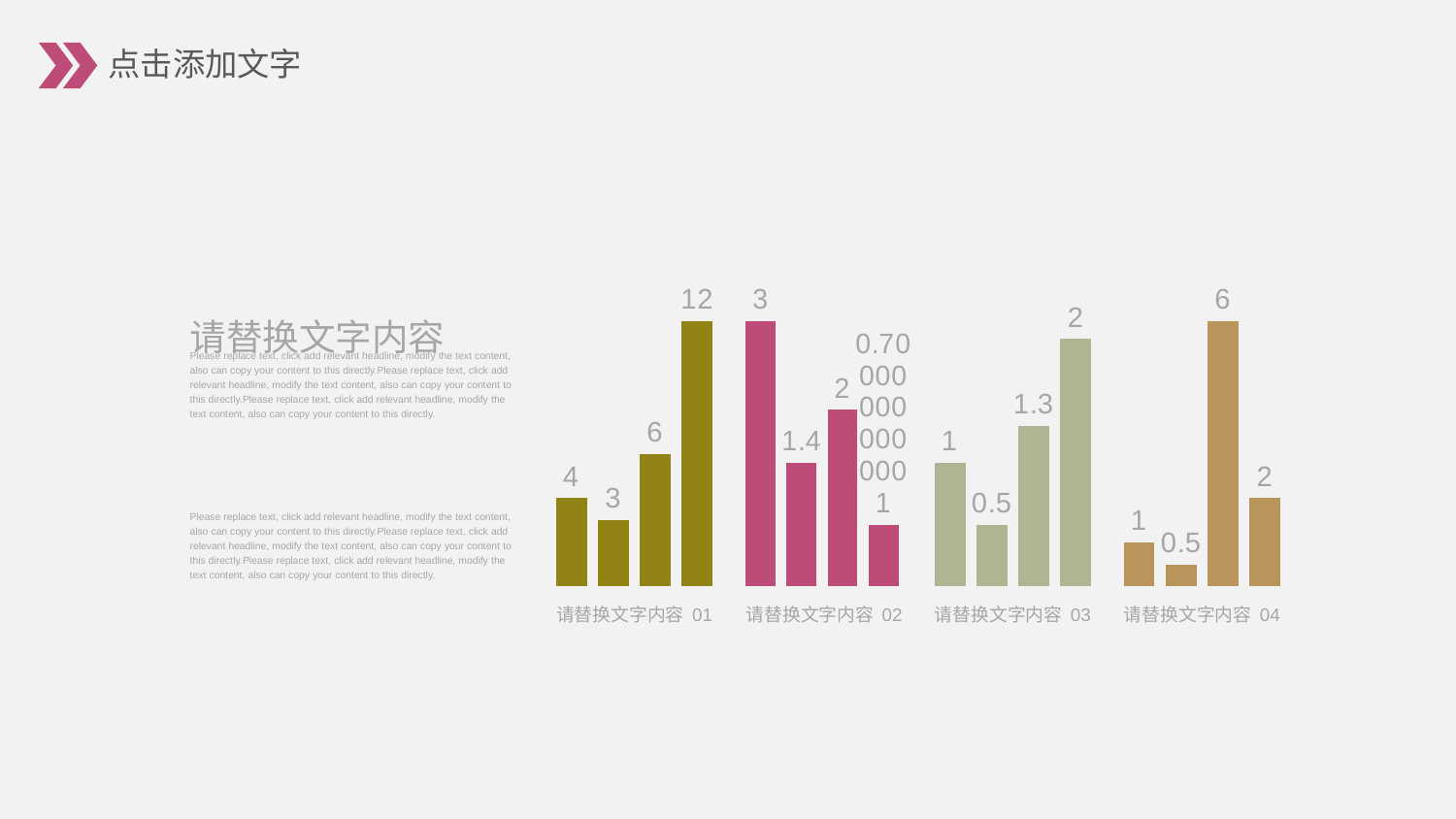
What is the value of the tallest bar in the 请替换文字内容 04 group? 6 What is the difference between the last bar in the 请替换文字内容 04 group and the last bar in the 请替换文字内容 02 group? 1.3 What is the value of the third bar in the 请替换文字内容 03 group? 1.3 Which is larger: the first bar in the 请替换文字内容 02 group or the first bar in the 请替换文字内容 03 group? 请替换文字内容 02 What kind of chart is shown on the slide? bar chart What is the lowest value labelled in the 请替换文字内容 03 group? 0.5 What is the value of the first bar in the 请替换文字内容 01 group? 4 What is the highest value labelled in the 请替换文字内容 01 group? 12 How many category groups are shown along the x axis of the chart? 4 What is the difference between the tallest and shortest bars in the 请替换文字内容 01 group? 9 What is the value of the second bar in the 请替换文字内容 02 group? 1.4 What colour are the bars in the 请替换文字内容 02 group? pink/magenta